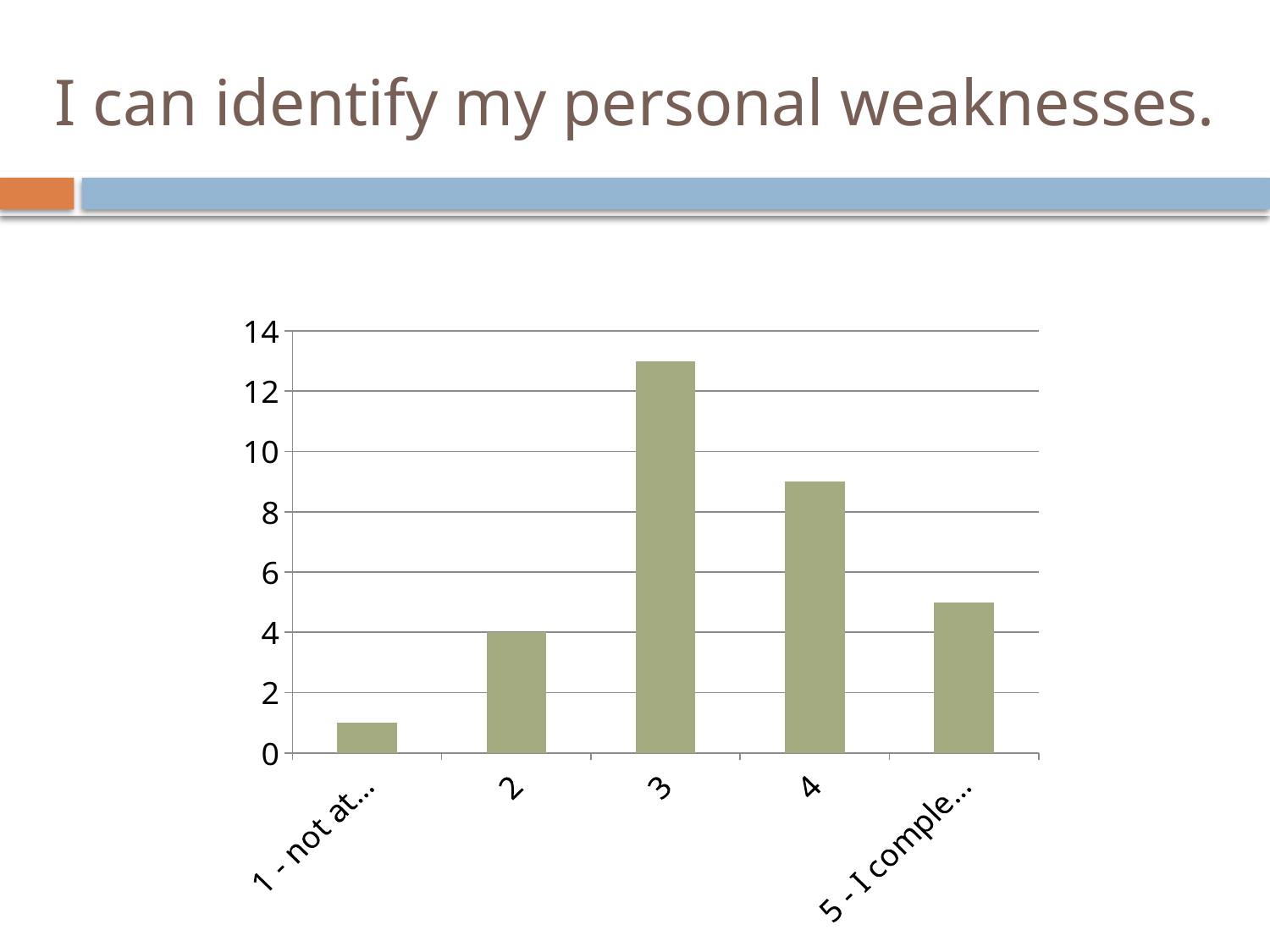
Is the value for category 4 greater or less than 8? greater What is the highest value shown on the y axis? 14 Which is larger, the value for category 4 or the value for category 2? 4 What is the value for category 2? 4 Is the value for the category labelled '1 - not at...' greater or less than 2? less Which category has the highest bar? 3 What kind of chart is shown on the slide? bar chart Which category has the lowest bar? 1 - not at... How many categories are shown on the x axis? 5 What is the title of the slide containing the chart? I can identify my personal weaknesses. Is the value for category 3 greater or less than 12? greater